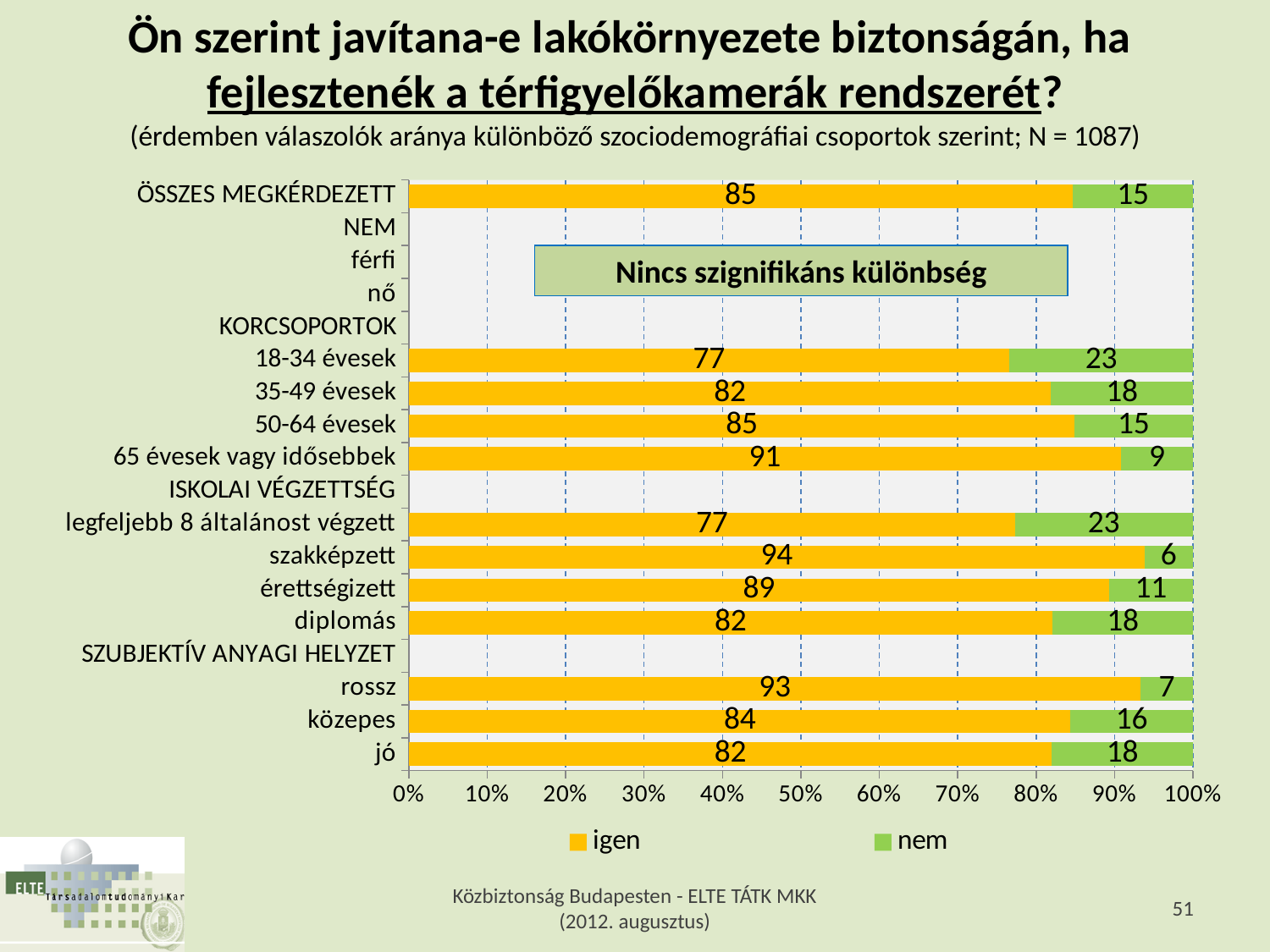
What is the total of the stacked bar for közepes? 100 What is the 'nem' value for rossz? 7 How many series does the legend list? 2 Which category has the lowest 'nem' value? szakképzett What are the two series named in the legend? igen, nem What kind of chart is shown on the slide? stacked bar chart What is the difference between the 'igen' values for szakképzett and diplomás? 12 What is the 'nem' value for 18-34 évesek? 23 What is the 'igen' value for 65 évesek vagy idősebbek? 91 Which has a larger 'igen' value, rossz or jó? rossz Which category has the highest 'igen' value? szakképzett What is the 'igen' value for ÖSSZES MEGKÉRDEZETT? 85